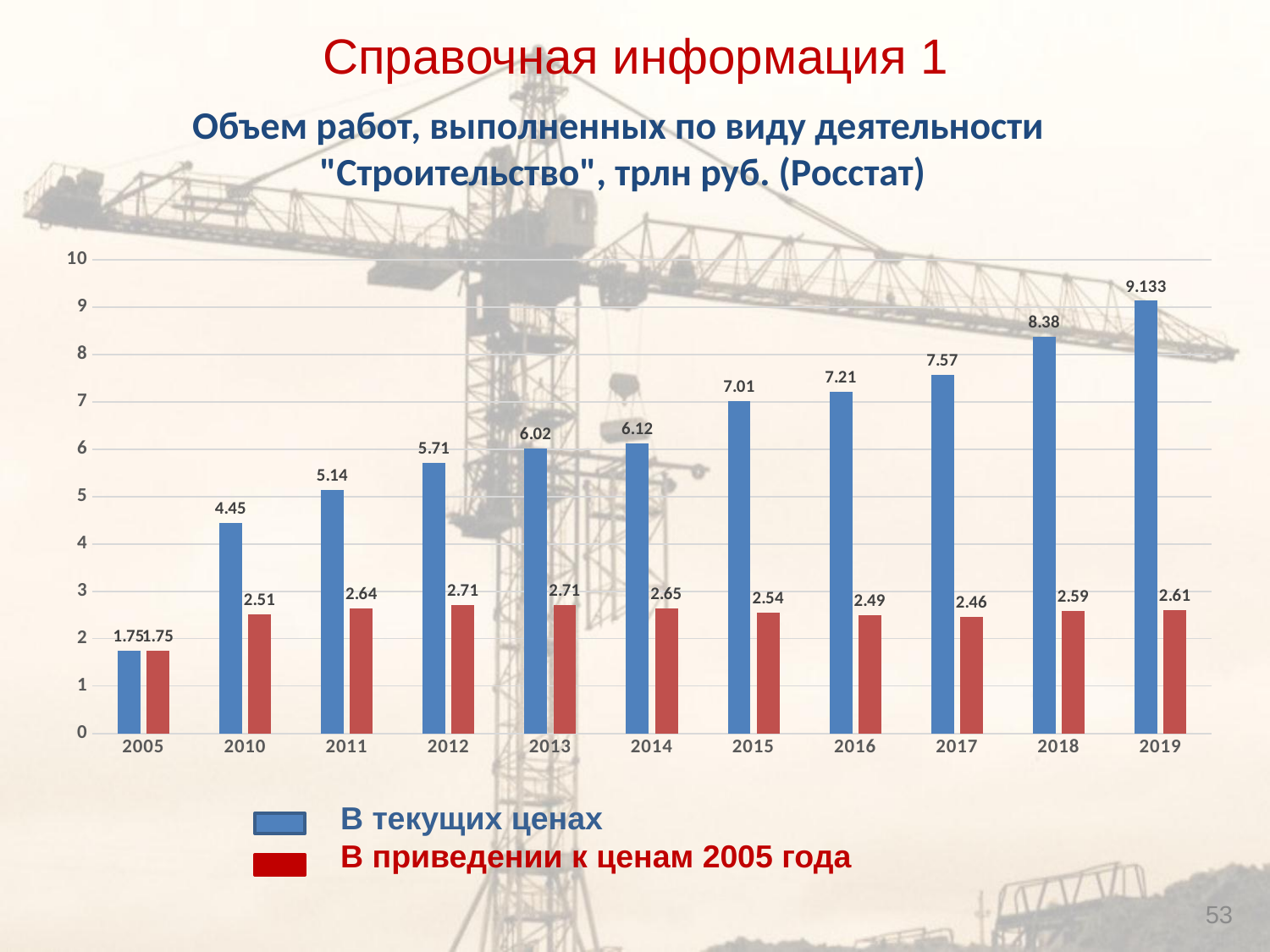
Which colour represents the "В приведении к ценам 2005 года" series? red Which year has the lowest value in the "В приведении к ценам 2005 года" series? 2005 How many series does the legend list? 2 What kind of chart is shown on the slide? bar chart Does the "В текущих ценах" series rise or fall from 2005 to 2019? rise Which is larger: the "В приведении к ценам 2005 года" value for 2011 or for 2017? 2011 Which year has the highest value in the "В текущих ценах" series? 2019 What is the value for 2012 in the "В приведении к ценам 2005 года" series? 2.71 What is the value for 2015 in the "В текущих ценах" series? 7.01 What is the difference between the "В текущих ценах" value and the "В приведении к ценам 2005 года" value for 2018? 5.79 What is the value for 2019 in the "В текущих ценах" series? 9.133 How many years are shown on the x axis? 11